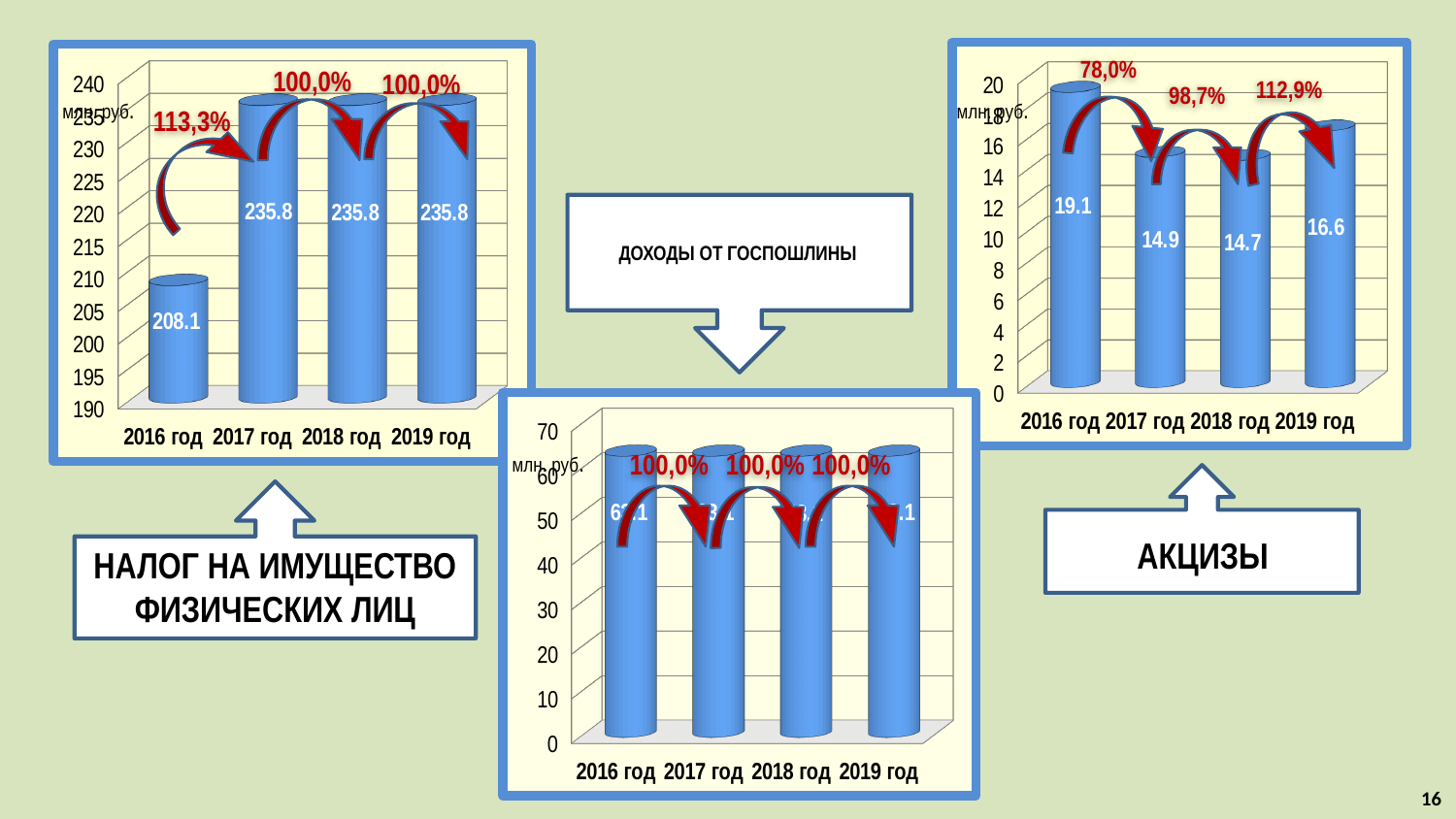
In the chart for 'Акцизы' (right), which is larger, the value for 2017 год or 2019 год? 2019 год In the chart for 'Акцизы' (right), what is the value for 2016 год? 19.1 What kind of chart is the chart for 'Акцизы' (right)? bar chart In the chart for 'Налог на имущество физических лиц' (left), what is the value for 2016 год? 208.1 In the chart for 'Налог на имущество физических лиц' (left), what is the value for 2018 год? 235.8 In the chart for 'Акцизы' (right), what is the value for 2019 год? 16.6 In the chart for 'Налог на имущество физических лиц' (left), which year has the lowest value? 2016 год In the chart for 'Доходы от госпошлины' (middle), is the value for 2016 год greater or less than 50? greater In the chart for 'Акцизы' (right), what is the difference between the values for 2016 год and 2018 год? 4.4 In the chart for 'Налог на имущество физических лиц' (left), what is the difference between the values for 2017 год and 2016 год? 27.7 In the chart for 'Акцизы' (right), which year has the highest value? 2016 год How many years are shown on the x axis of the chart for 'Доходы от госпошлины' (middle)? 4